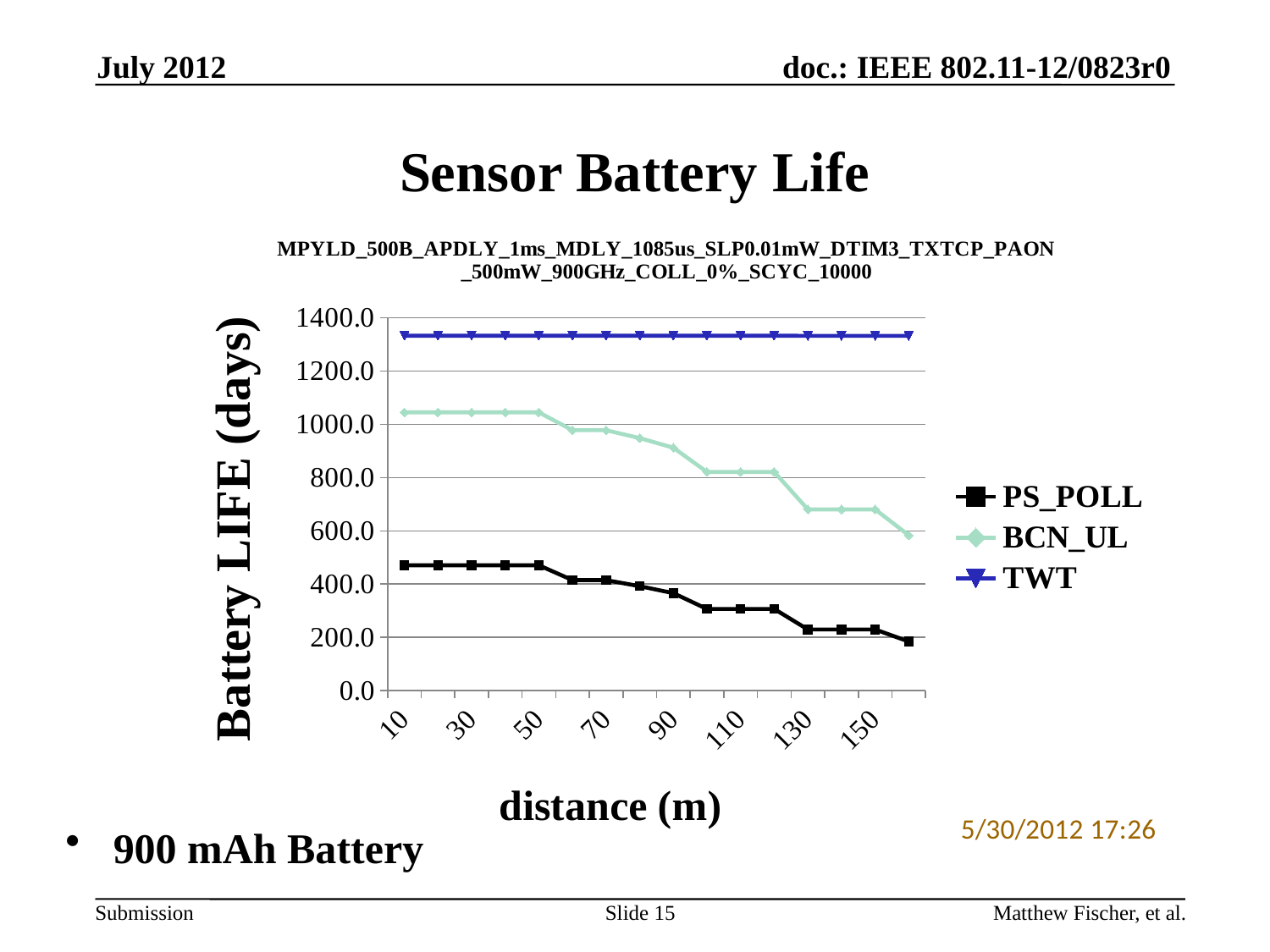
Which series has the lowest battery life across all distances? PS_POLL Which series are listed in the legend? PS_POLL, BCN_UL, TWT Which series has the highest battery life across all distances? TWT Is the value for PS_POLL at 10 m greater or less than 600? less How many series does the legend list? 3 Is the value for PS_POLL at 150 m greater or less than 400? less Is the value for TWT at 10 m greater or less than 1200? greater Does the PS_POLL battery life rise or fall as distance increases? fall What is the title of the y axis? Battery LIFE (days) What kind of chart is shown on the slide? line chart At 150 m, which series has the larger battery life, BCN_UL or PS_POLL? BCN_UL